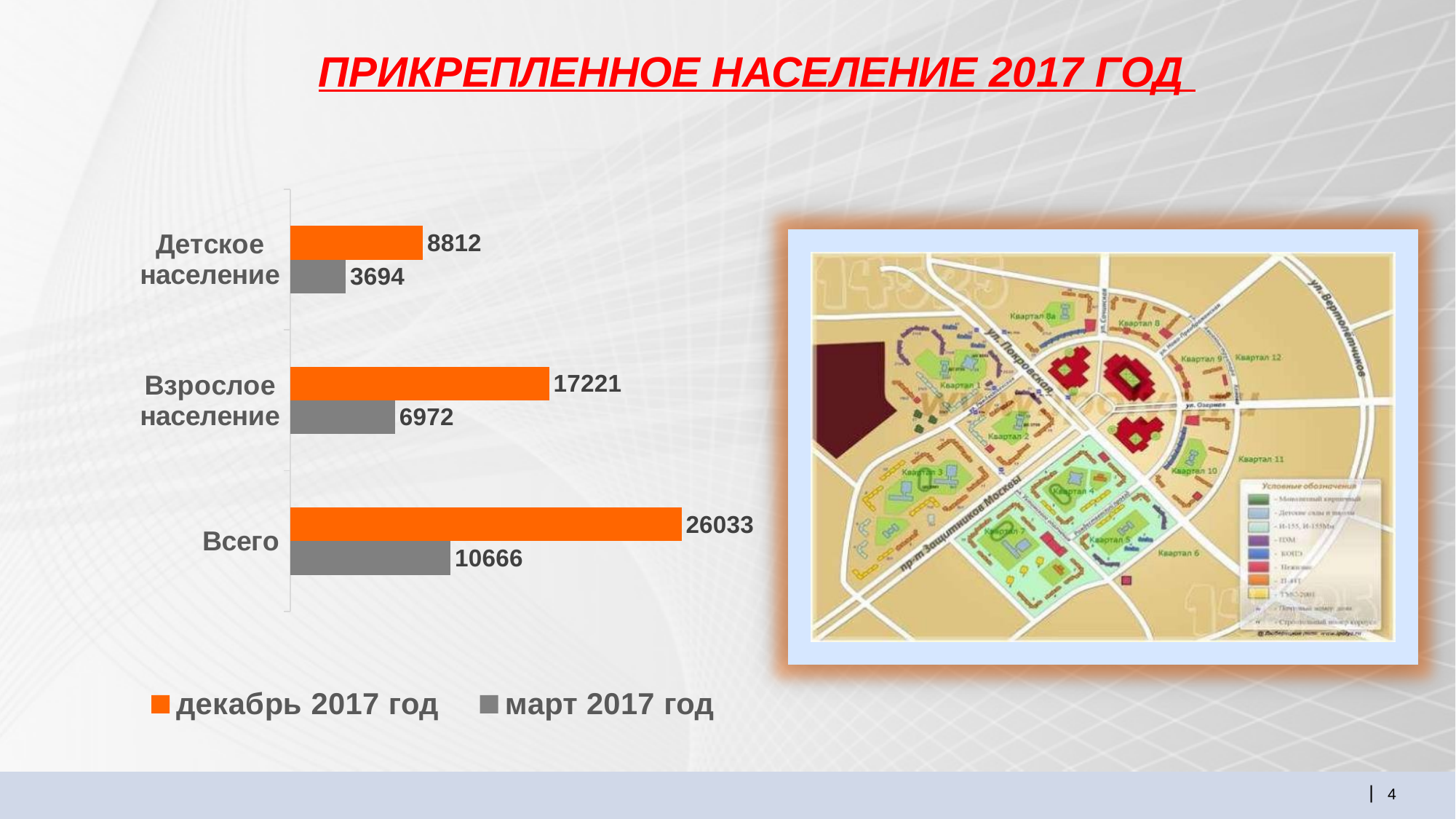
What is the difference between the декабрь 2017 год and март 2017 год values for Взрослое население? 10249 What is the value for Детское население in the декабрь 2017 год series? 8812 What is the value for Всего in the декабрь 2017 год series? 26033 What is the value for Детское население in the март 2017 год series? 3694 How many series does the legend list? 2 What is the value for Взрослое население in the март 2017 год series? 6972 Which category has the lowest value in the декабрь 2017 год series? Детское население What kind of chart is shown on the slide? bar chart How many categories are shown on the chart? 3 Which category has the highest value in the март 2017 год series? Всего Which colour represents the март 2017 год series? grey Which is larger for Всего: the декабрь 2017 год value or the март 2017 год value? декабрь 2017 год